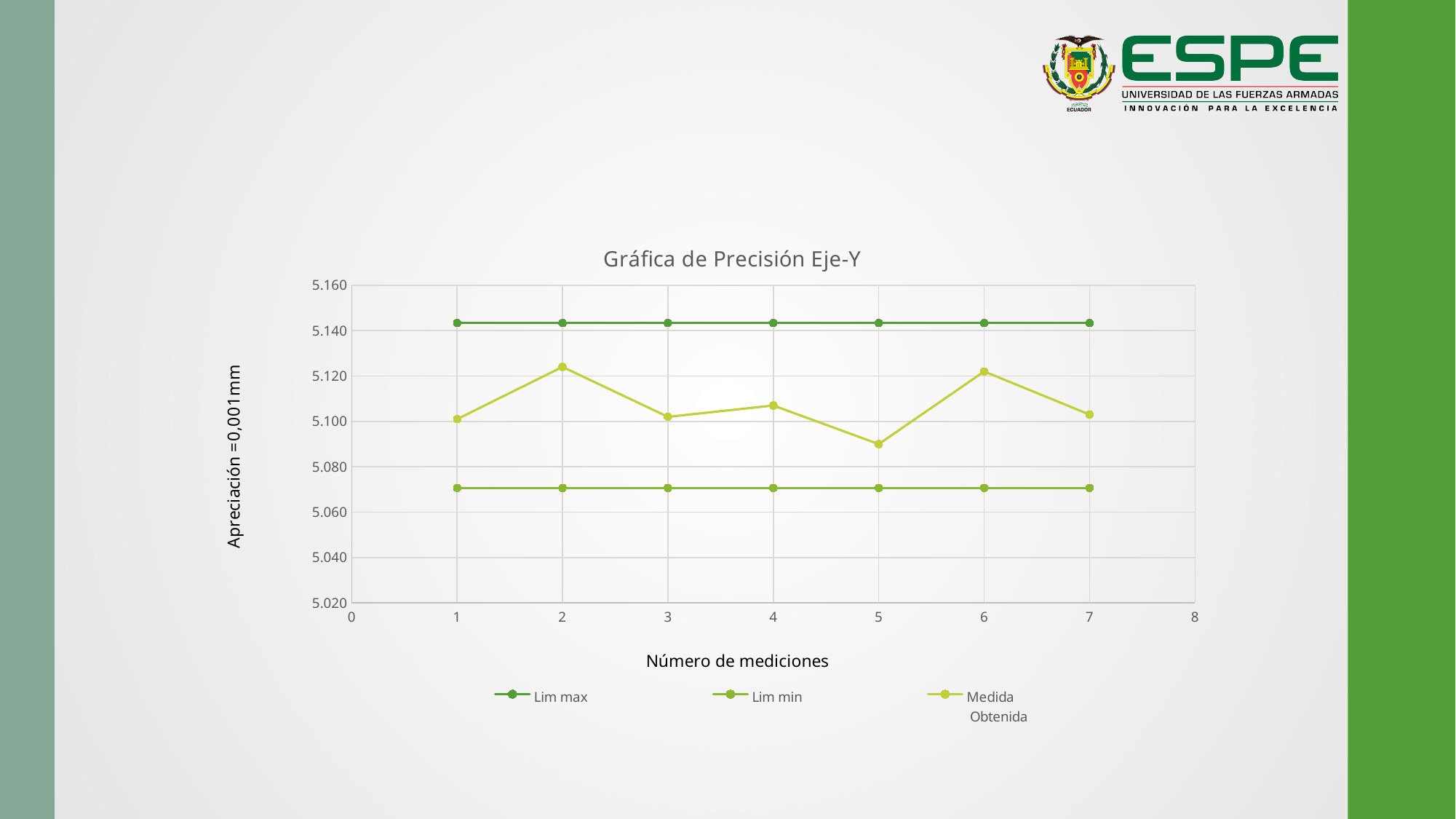
Is the Medida Obtenida value at measurement 5 greater or less than 5.100? less How many measurement points are plotted for the Medida Obtenida series? 7 Is the value of Lim max greater or less than 5.140? greater Is the value of Lim min greater or less than 5.080? less How many series does the legend list? 3 What is the title of the chart? Gráfica de Precisión Eje-Y What is the label of the x axis? Número de mediciones Which is larger, the Medida Obtenida value at measurement 2 or at measurement 5? measurement 2 Which series has higher values, Lim max or Lim min? Lim max What kind of chart is shown on the slide? line chart At which measurement number is the Medida Obtenida value lowest? 5